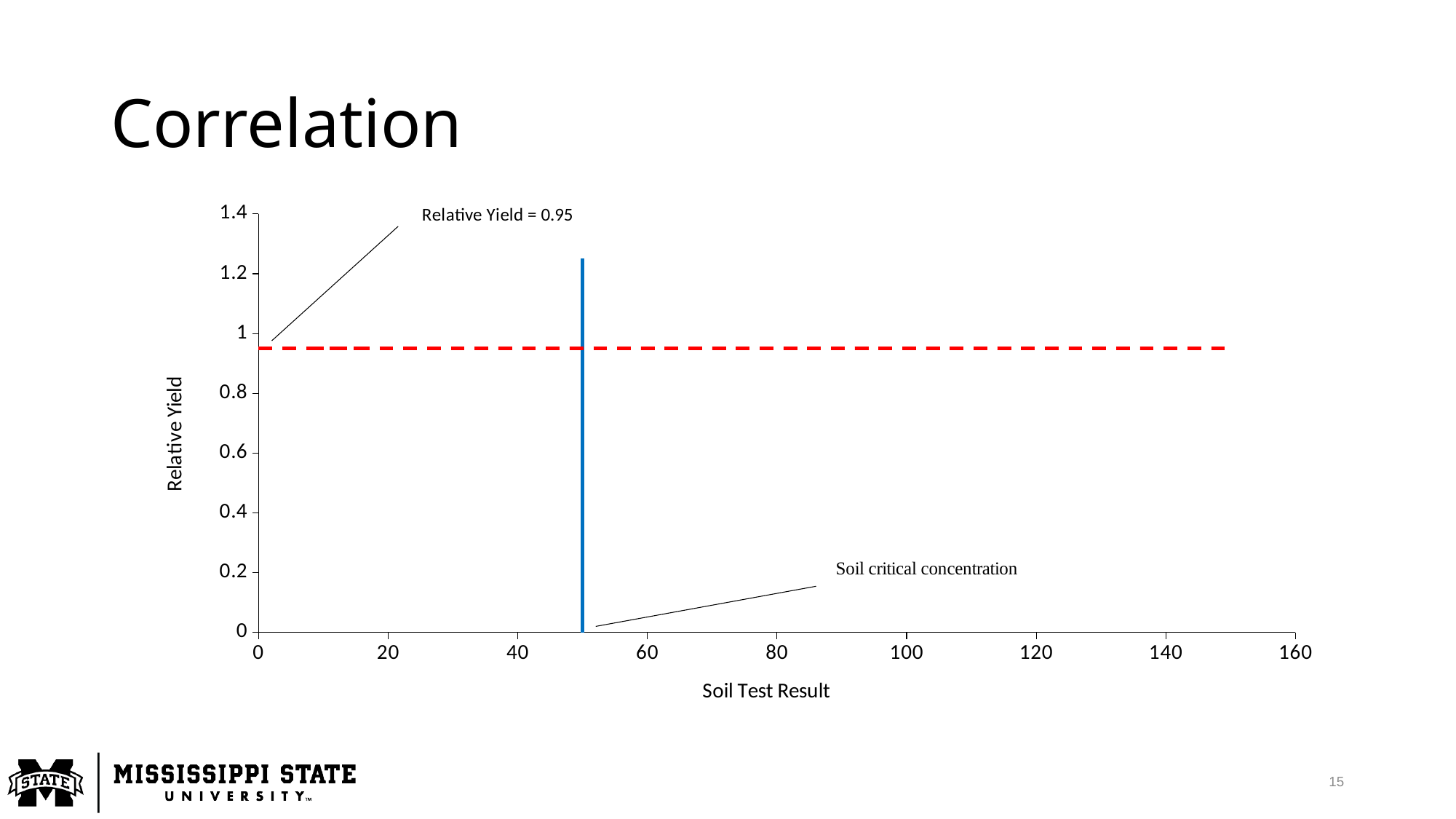
What relative yield value does the dashed red horizontal line represent? 0.95 Is the soil critical concentration marked by the blue line greater or less than 40? greater Does the dashed red line rise, fall, or stay flat as the soil test result increases? stay flat What kind of chart is shown on the slide? line chart Is the soil critical concentration marked by the blue line greater or less than 60? less Is the relative yield marked by the dashed red line greater or less than 1? less What is the title of the x axis? Soil Test Result What label is attached to the vertical blue line? Soil critical concentration